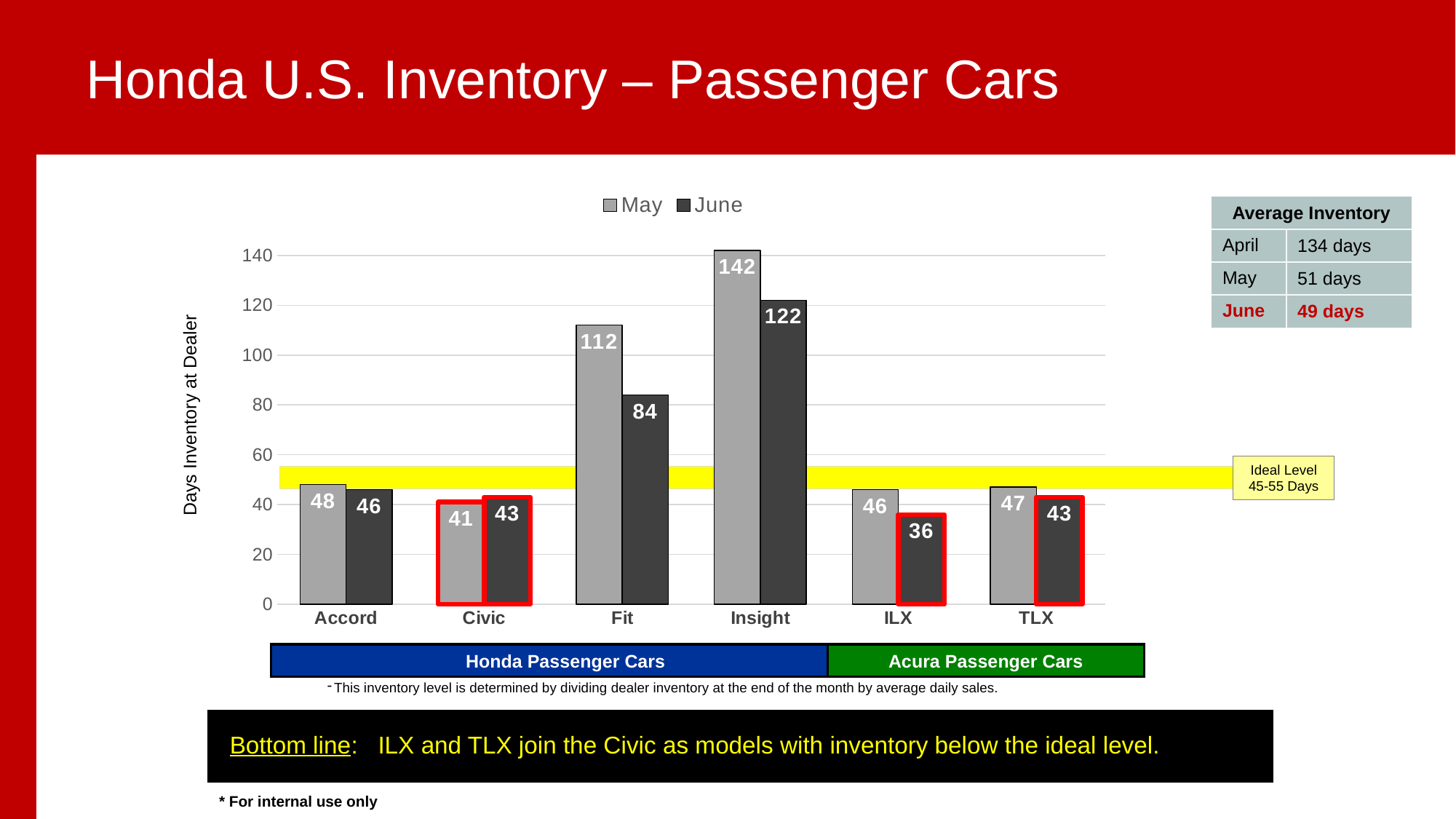
How many car models are shown on the x axis of the chart? 6 Which model has the highest June days inventory? Insight What is the June days inventory value for ILX? 36 What is the label of the y axis of the chart? Days Inventory at Dealer Is the June value for Insight greater or less than 100? greater How many series does the chart legend list? 2 What is the June days inventory value for Fit? 84 Which model has the lowest June days inventory? ILX What kind of chart is shown on the slide? Bar chart Which is larger, the May value for Civic or the June value for Civic? June value for Civic What is the difference between the May and June values for Fit? 28 What is the May days inventory value for Insight? 142